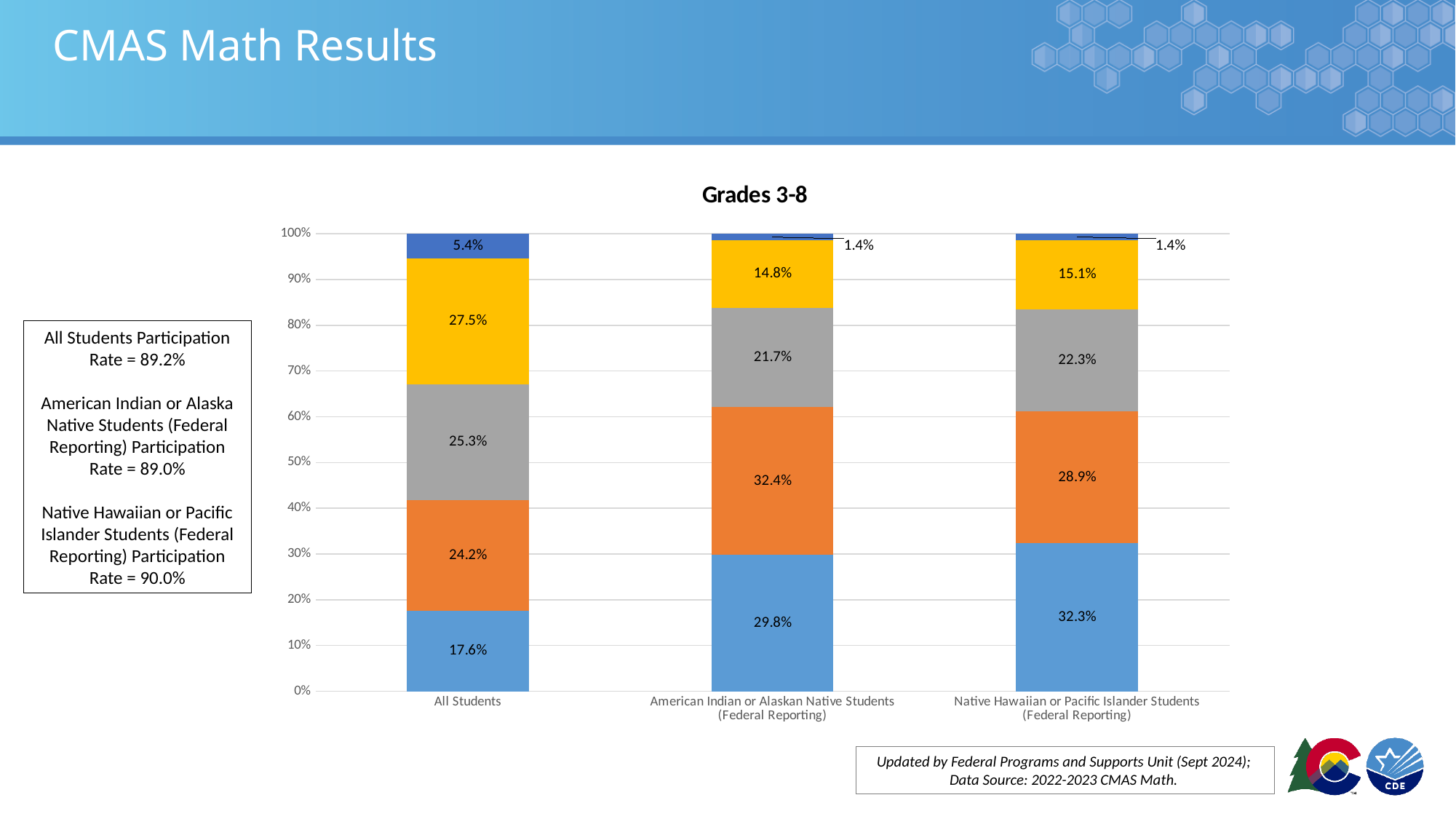
Which is larger: the gray segment for All Students or the gray segment for Native Hawaiian or Pacific Islander Students (Federal Reporting)? All Students Which student group has the largest yellow segment? All Students What is the value of the orange segment for American Indian or Alaskan Native Students (Federal Reporting)? 32.4% What type of chart is shown on the slide? Stacked bar chart What is the value of the bottom light blue segment for All Students? 17.6% What is the title of the chart? Grades 3-8 What is the value of the top dark blue segment for All Students? 5.4% How many student groups (categories) are shown on the x axis of the chart? 3 What is the value of the gray segment for American Indian or Alaskan Native Students (Federal Reporting)? 21.7% Which student group has the largest bottom light blue segment? Native Hawaiian or Pacific Islander Students (Federal Reporting) What is the difference between the orange segment for American Indian or Alaskan Native Students (Federal Reporting) and the orange segment for All Students? 8.2 percentage points What is the value of the yellow segment for Native Hawaiian or Pacific Islander Students (Federal Reporting)? 15.1%